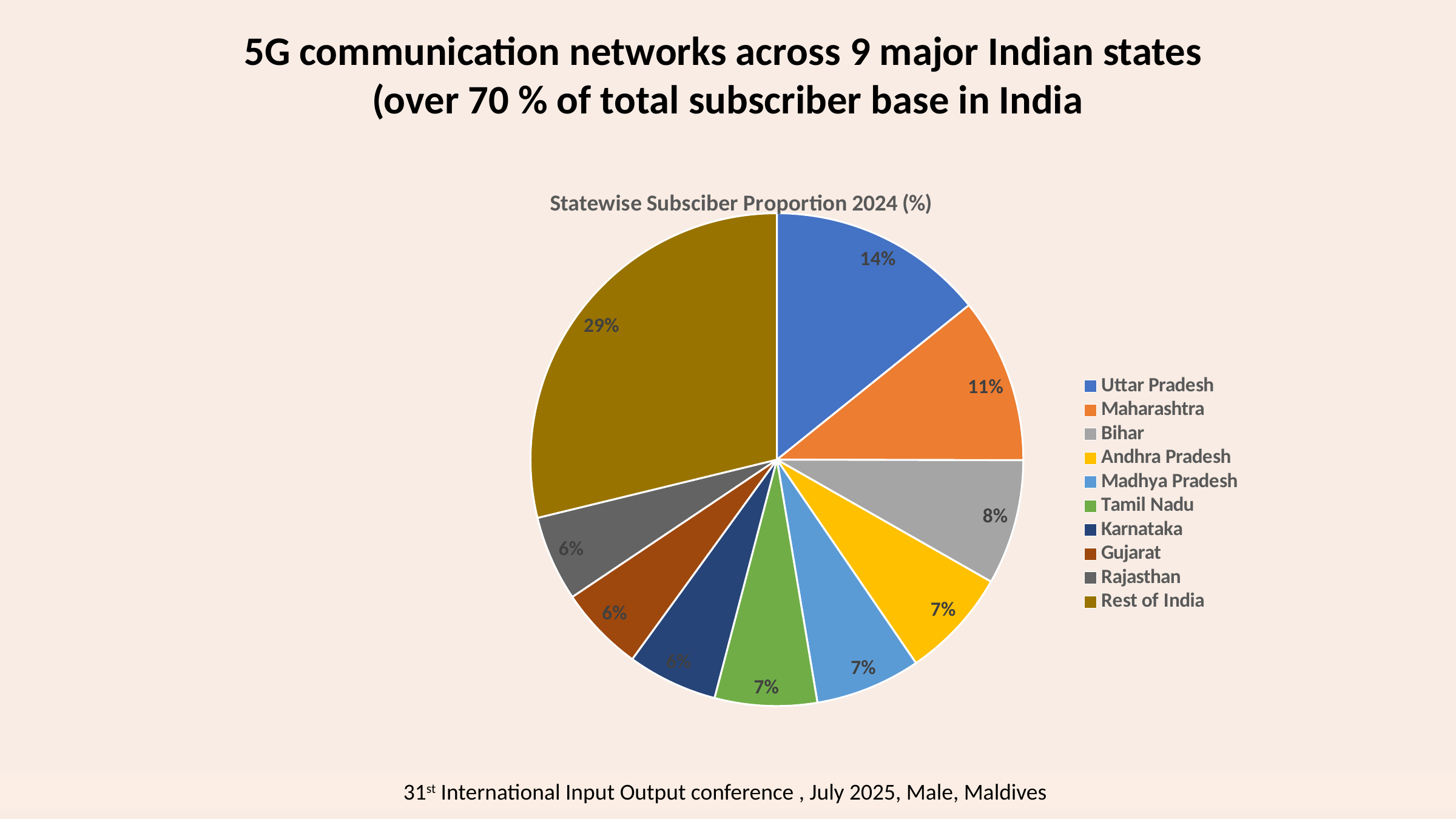
What is the difference between the shares of Uttar Pradesh and Maharashtra? 3% What share of subscribers does Uttar Pradesh have? 14% What share of subscribers does Bihar have? 8% What type of chart is shown on the slide? Pie chart What share of subscribers does Rest of India have? 29% Among the named states (excluding Rest of India), which has the largest share? Uttar Pradesh What is the chart's title? Statewise Subsciber Proportion 2024 (%) Which slice of the pie is the largest? Rest of India Which has a larger share, Bihar or Gujarat? Bihar What share of subscribers does Maharashtra have? 11% How many slices does the pie chart have? 10 What is the difference between the shares of Rest of India and Uttar Pradesh? 15%